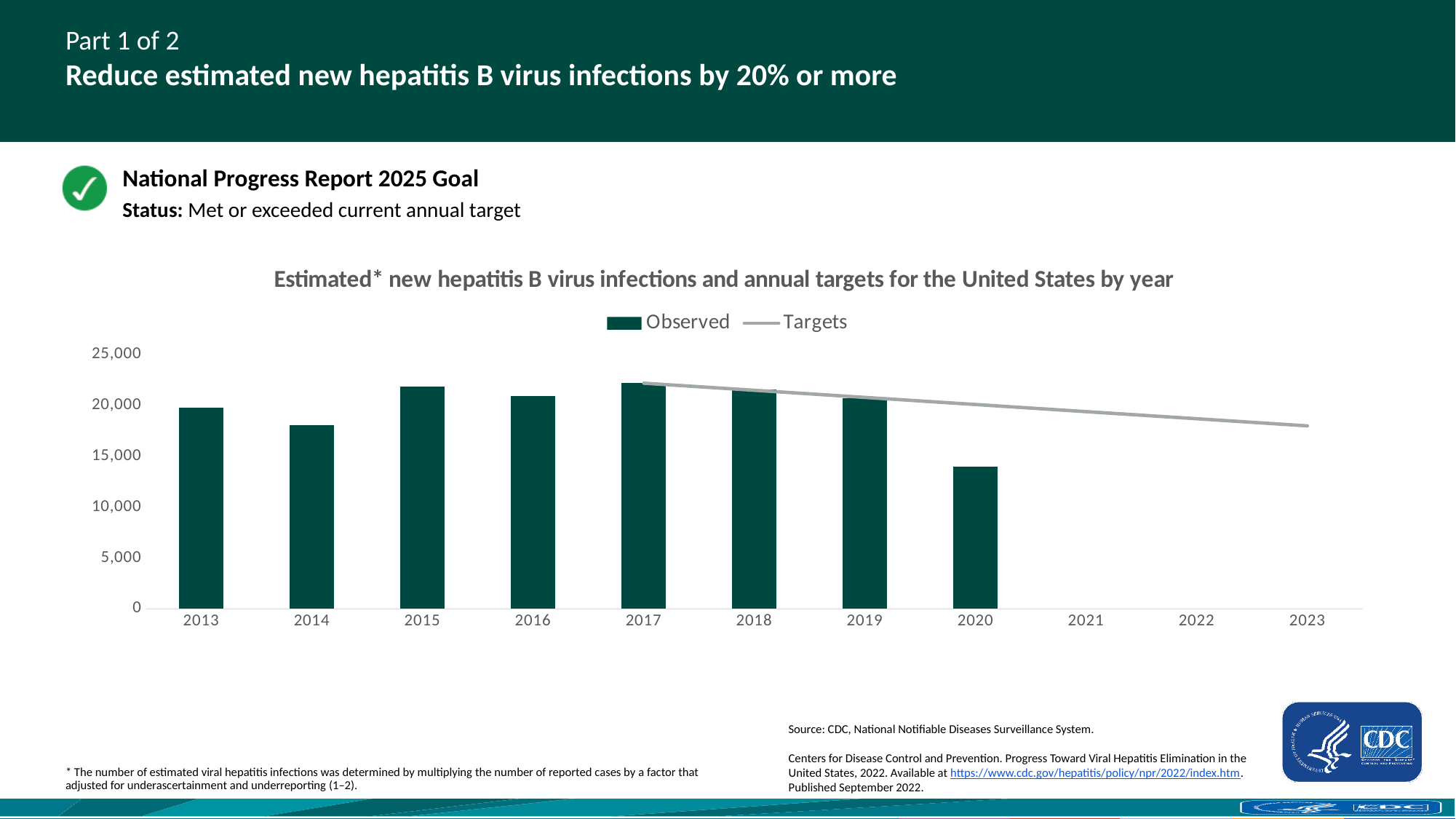
Which year has the lowest Observed value of estimated new hepatitis B virus infections? 2020 Which year has the larger Observed value, 2013 or 2020? 2013 Which year has the larger Observed value, 2014 or 2015? 2015 Is the Observed value for 2017 greater or less than 20,000? greater Is the Observed value for 2014 greater or less than 20,000? less How many years have an Observed bar plotted in the chart? 8 Is the Observed value for 2015 greater or less than 20,000? greater Do the Observed values rise or fall from 2017 to 2020? fall What are the two series named in the chart legend? Observed and Targets What kind of chart is shown on the slide? Bar chart (with a target line) How many series does the chart legend list? 2